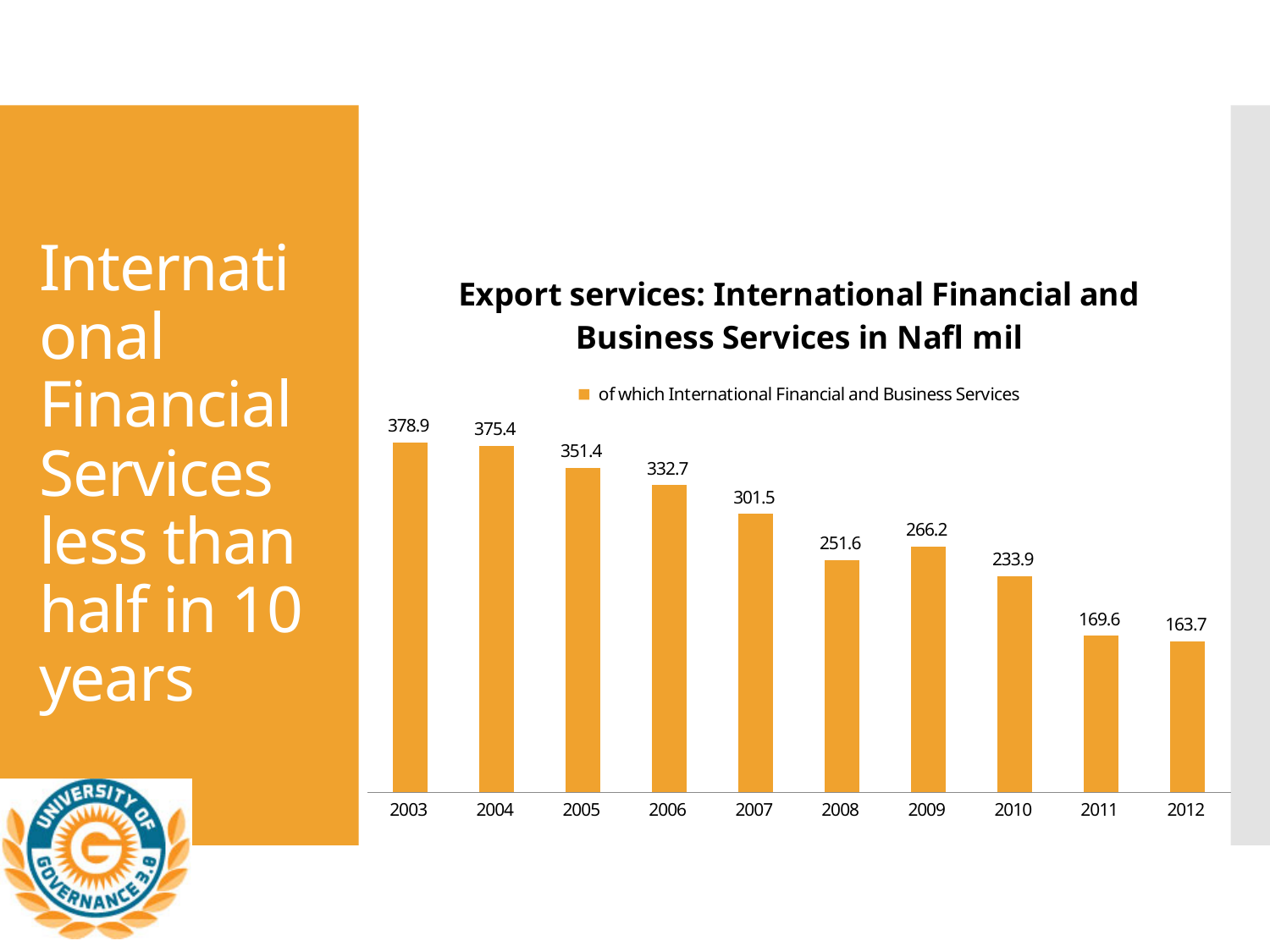
How many series does the legend list? 1 What is the value for 2003? 378.9 How many years are shown on the x axis? 10 Do the values generally rise or fall from 2003 to 2012? fall Which year has the lowest value? 2012 What is the legend entry for the series? of which International Financial and Business Services What is the value for 2009? 266.2 Which is larger, the value for 2008 or the value for 2009? 2009 What kind of chart is shown? bar chart Which year has the highest value? 2003 What is the difference between the values for 2003 and 2012? 215.2 What is the value for 2012? 163.7